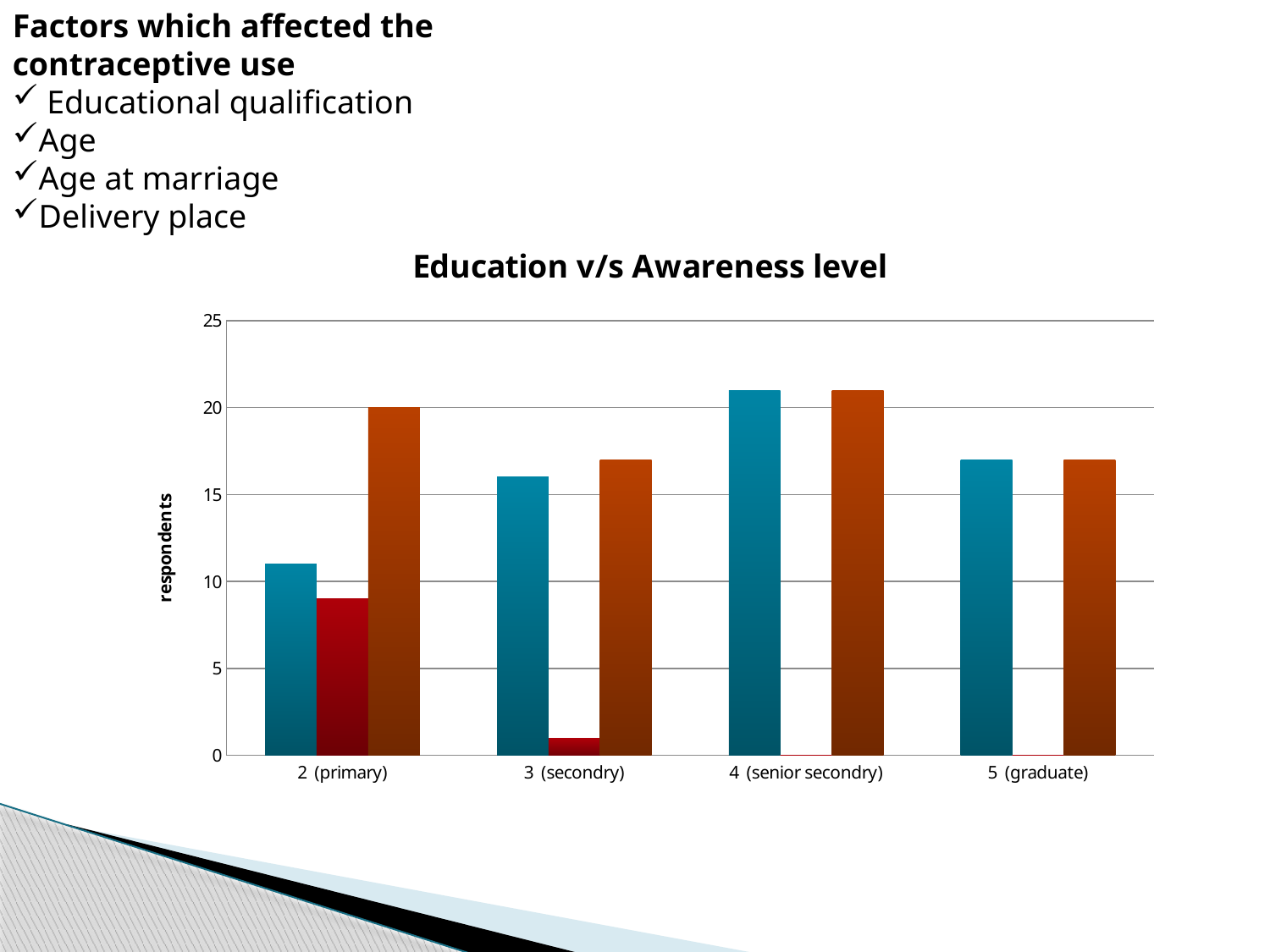
Is the value of the red bar for 3 (secondry) greater or less than 5? less Is the value of the blue bar for 2 (primary) greater or less than 15? less How many education categories are shown on the x axis of the chart? 4 In the 2 (primary) category, which bar is larger, the blue bar or the orange bar? orange For which category is the blue bar the lowest? 2 (primary) For which category is the blue bar the highest? 4 (senior secondry) Is the value of the blue bar for 4 (senior secondry) greater or less than 20? greater For which category is the red bar the highest? 2 (primary) What is the value of the orange bar for the 2 (primary) category? 20 What is the label of the vertical axis of the chart? respondents What kind of chart is shown on the slide? bar chart What is the title of the chart? Education v/s Awareness level